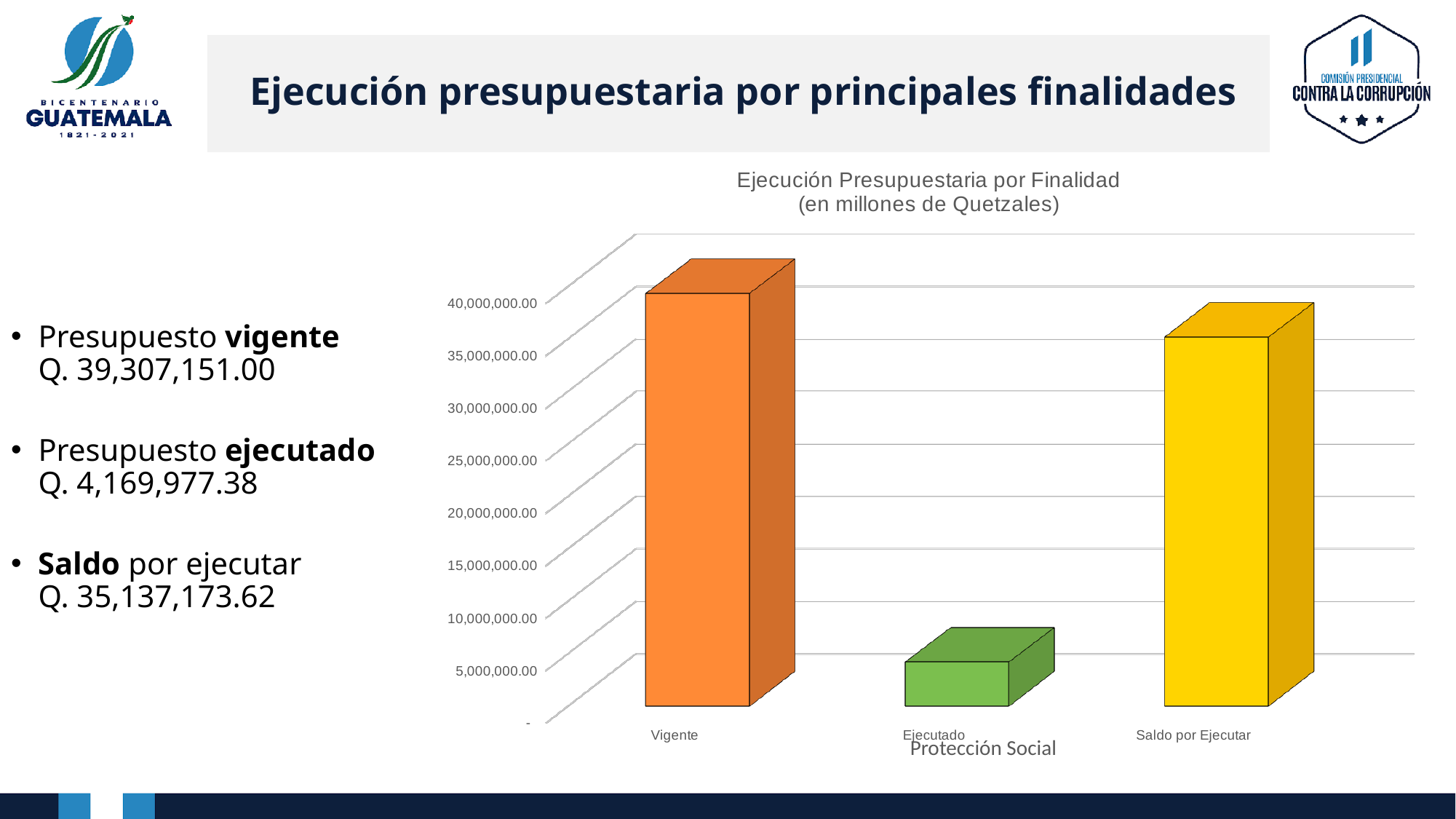
How many categories are plotted in the chart? 3 According to the slide, what is the value of the presupuesto vigente? Q. 39,307,151.00 What is the title of the chart? Ejecución Presupuestaria por Finalidad (en millones de Quetzales) Which is larger, the bar for Vigente or the bar for Saldo por Ejecutar? Vigente What kind of chart is shown on the slide? bar chart Is the value for Saldo por Ejecutar greater or less than 30,000,000.00? greater Which category has the highest bar in the chart? Vigente According to the slide, what is the value of the presupuesto ejecutado? Q. 4,169,977.38 Which category has the lowest bar in the chart? Ejecutado What colour is the bar for Vigente? orange Is the value for Ejecutado greater or less than 5,000,000.00? less Is the value for Vigente greater or less than 35,000,000.00? greater